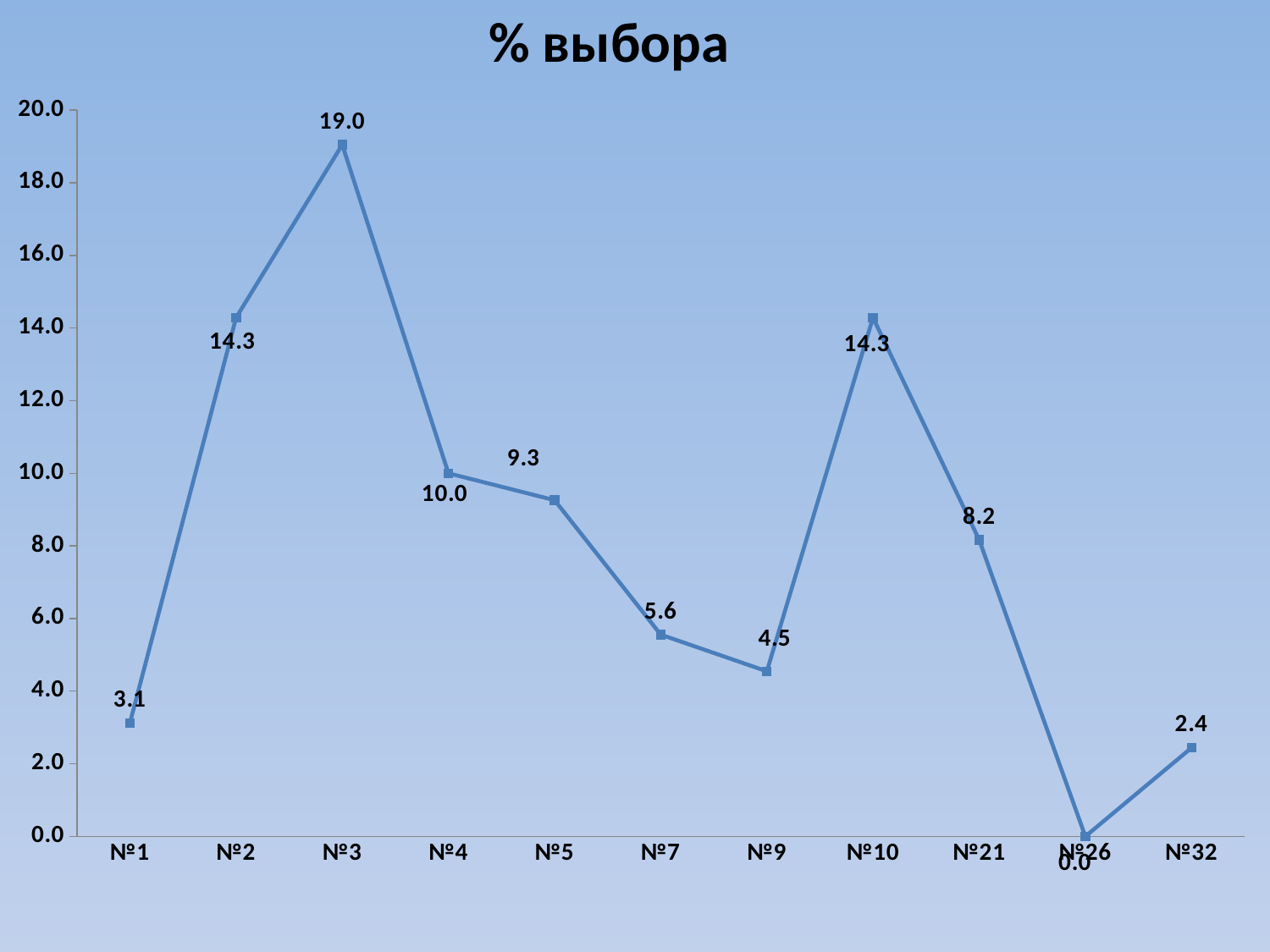
Which is larger, the value for №5 or the value for №7? №5 Do the values rise or fall from №10 to №26? fall What is the difference between the values for №3 and №4? 9.0 What is the value for №9? 4.5 How many categories are plotted on the x axis? 11 What is the value for №3? 19.0 What is the title of the chart? % выбора Is the value for №2 greater or less than 12.0? greater Which category has the highest value? №3 Which category has the lowest value? №26 What is the value for №21? 8.2 What kind of chart is shown? line chart